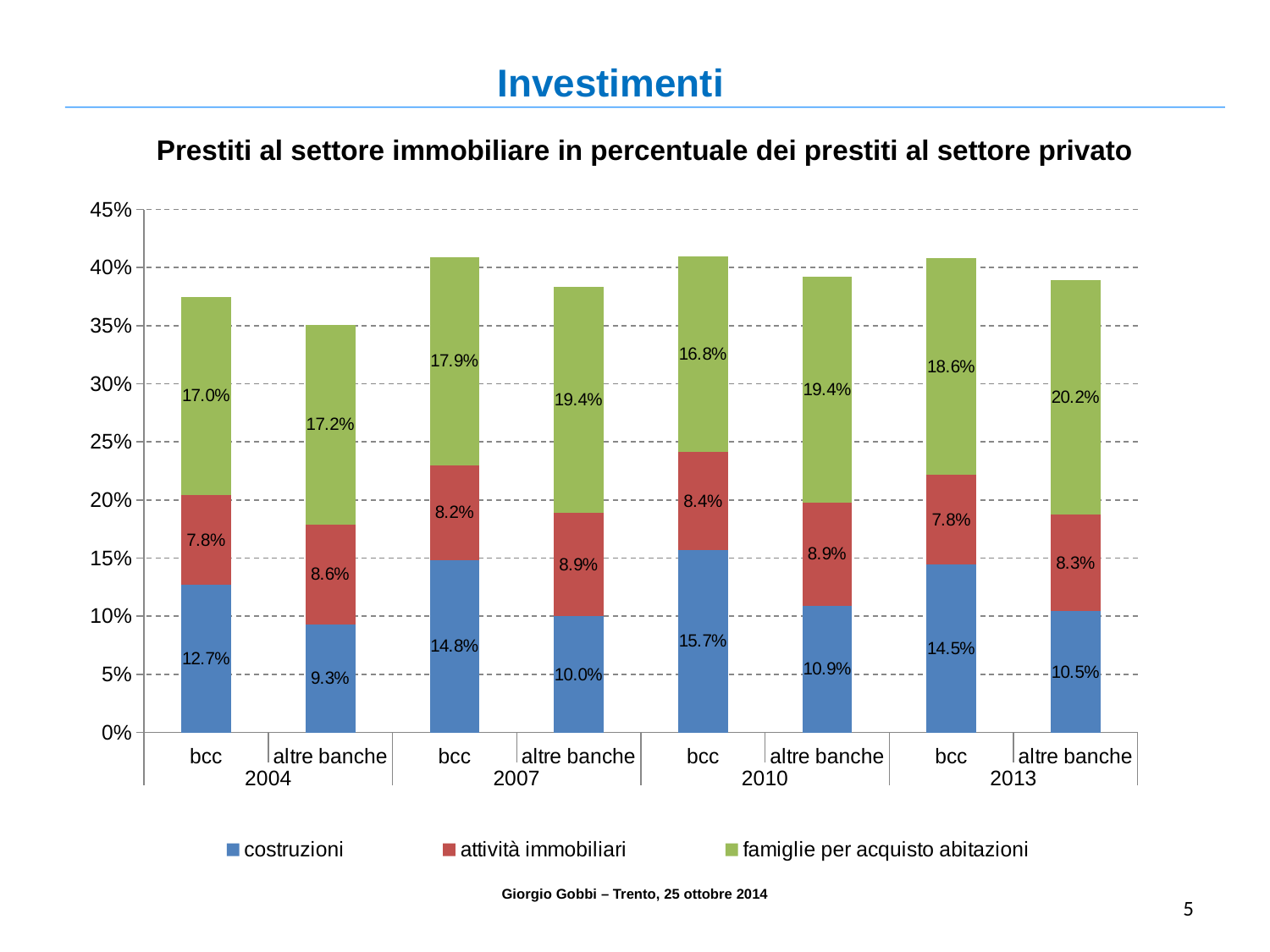
How many stacked bars are shown in the chart? 8 How many series does the legend list? 3 Which bar has the highest value for costruzioni? bcc 2010 What is the value for costruzioni for bcc in 2004? 12.7% Which is larger, the famiglie per acquisto abitazioni value for bcc in 2007 or for altre banche in 2007? altre banche in 2007 What is the value for famiglie per acquisto abitazioni for altre banche in 2013? 20.2% What is the total of the stacked bar for bcc in 2004? 37.5% What kind of chart is shown on the slide? Stacked bar chart What is the difference between the costruzioni values for bcc and altre banche in 2013? 4.0% Is the total of the stacked bar for bcc in 2007 greater or less than 40%? greater What is the value for attività immobiliari for altre banche in 2007? 8.9% Which bar has the lowest value for costruzioni? altre banche 2004